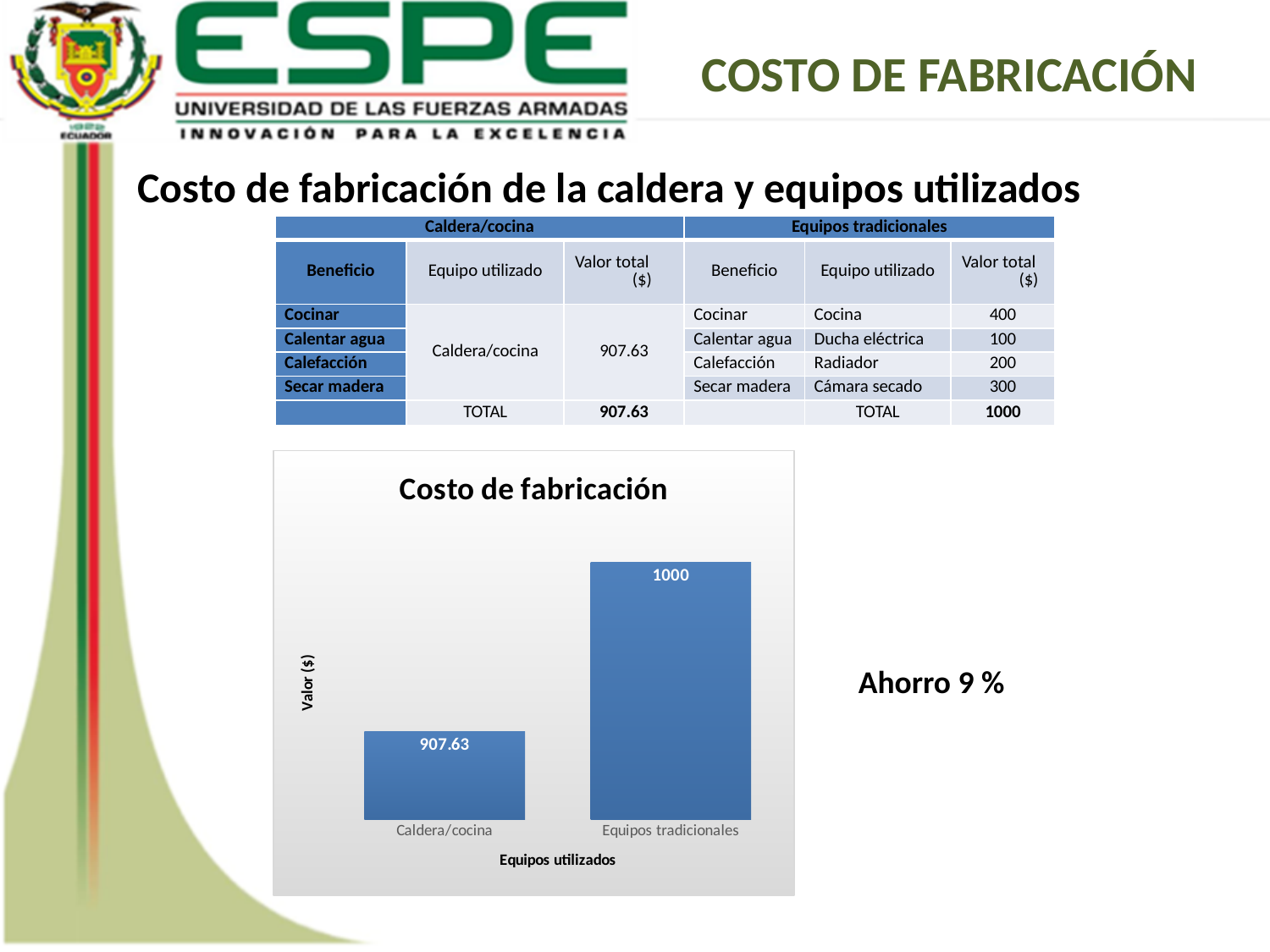
What is the label of the y axis in the Costo de fabricación chart? Valor ($) What is the title of the chart on the slide? Costo de fabricación What is the value for Caldera/cocina in the Costo de fabricación chart? 907.63 What is the value for Equipos tradicionales in the Costo de fabricación chart? 1000 What kind of chart is the Costo de fabricación chart? Bar chart Which category has the lowest value in the Costo de fabricación chart? Caldera/cocina Which is larger in the Costo de fabricación chart: Caldera/cocina or Equipos tradicionales? Equipos tradicionales What is the difference between the values for Equipos tradicionales and Caldera/cocina in the Costo de fabricación chart? 92.37 Do the values rise or fall from left to right in the Costo de fabricación chart? Rise Which category has the highest value in the Costo de fabricación chart? Equipos tradicionales How many categories are shown in the Costo de fabricación chart? 2